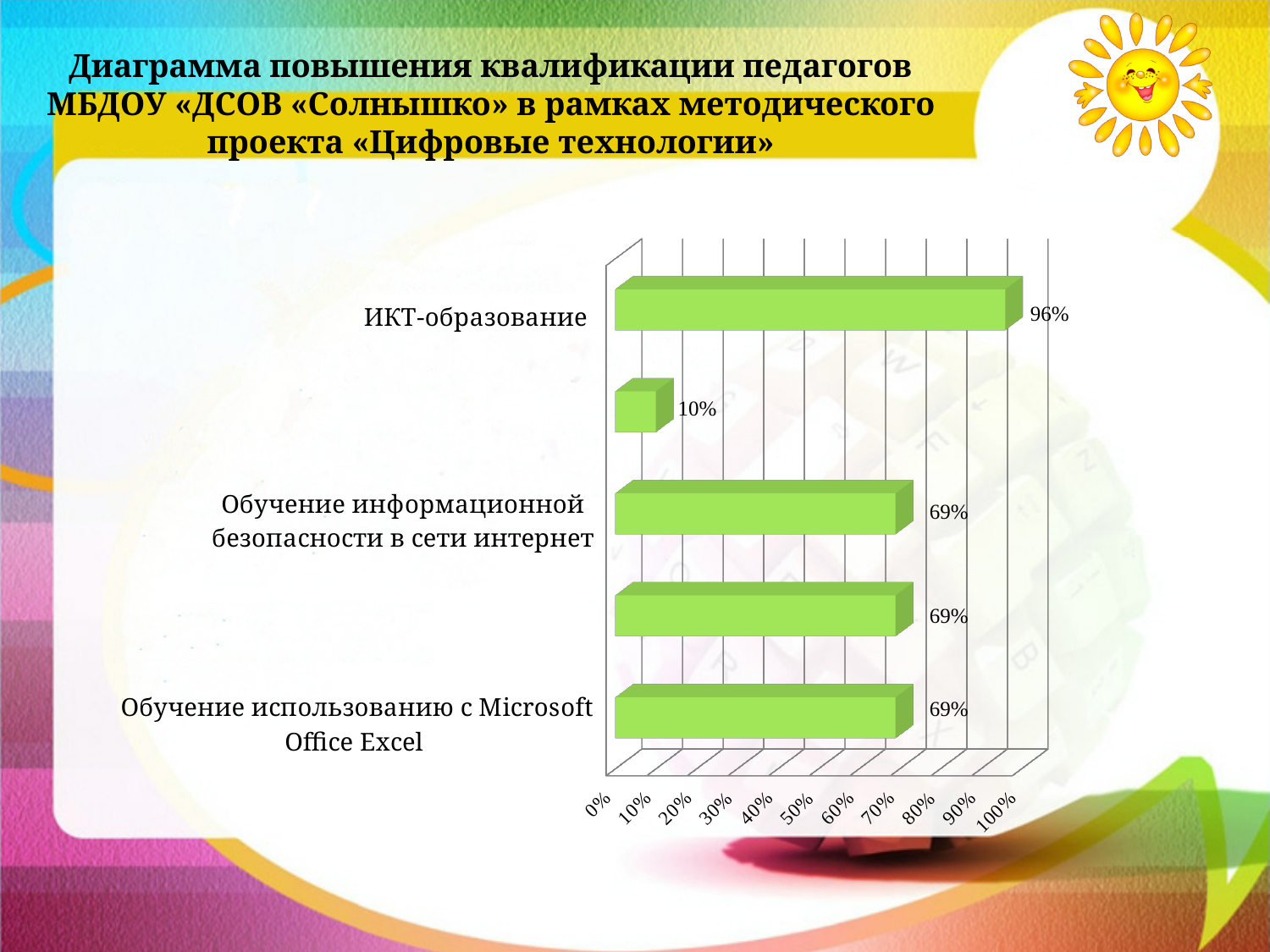
What is the value for Обучение использованию с Microsoft Office Excel? 69% What kind of chart is shown on the slide? bar chart What is the value for ИКТ-образование? 96% How many bars have a data label of 69%? 3 What is the value for Обучение информационной безопасности в сети интернет? 69% What is the difference between the value for ИКТ-образование and the value for Обучение использованию с Microsoft Office Excel? 27% Which is larger: the value for ИКТ-образование or the value for Обучение информационной безопасности в сети интернет? ИКТ-образование How many bars are plotted on the chart? 5 What is the smallest data label value shown on the chart? 10% Which category has the highest value? ИКТ-образование What is the highest tick value shown on the value axis? 100% Is the value for ИКТ-образование greater or less than 90%? greater